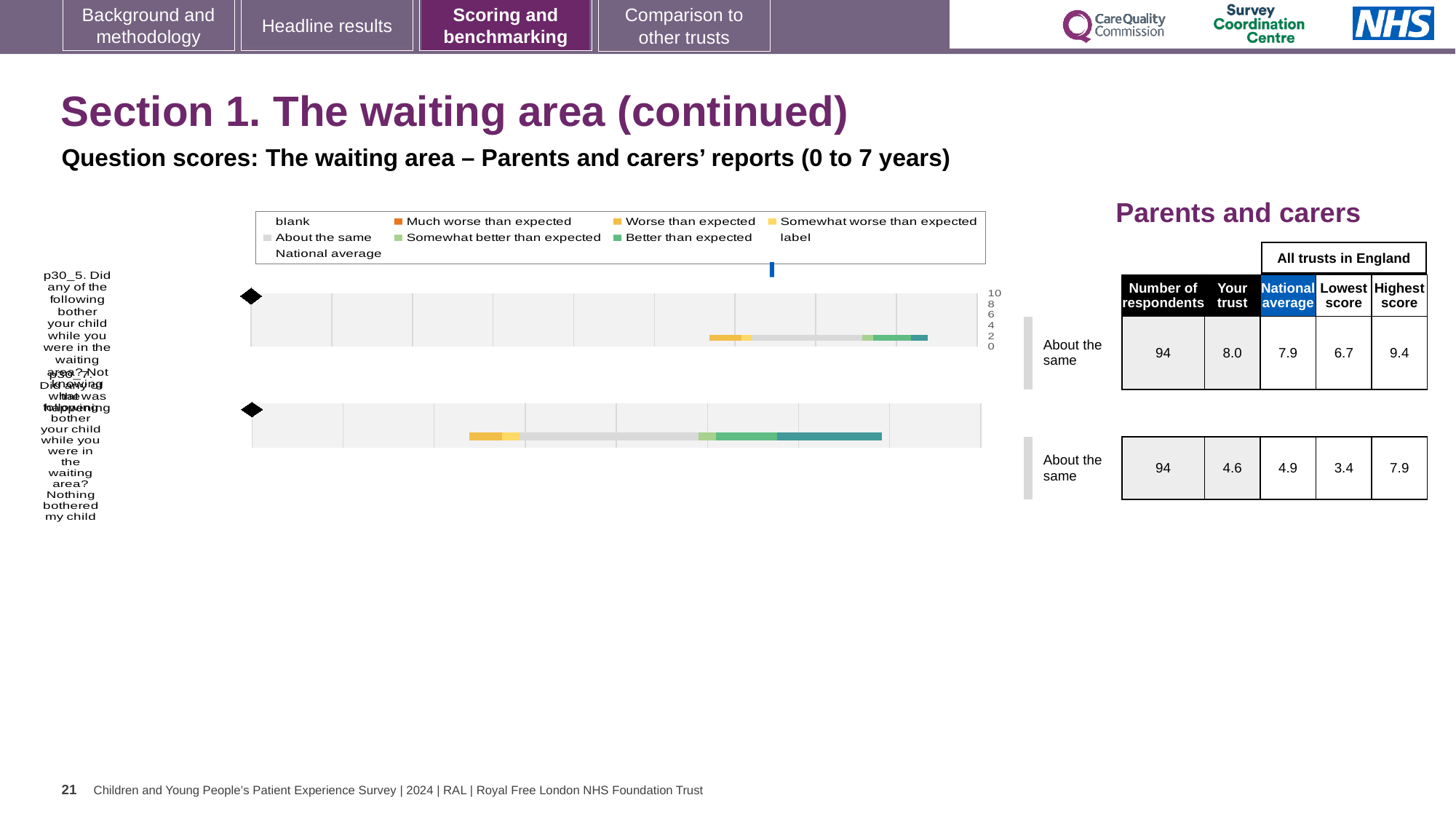
What benchmark category is assigned to both bars in the chart? About the same For the bottom bar (p30_7), which is larger: the 'Your trust' score or the national average? National average What kind of chart is shown on the slide? bar chart What is the 'Your trust' score for the bottom bar (p30_7)? 4.6 What is the difference between the highest and lowest scores for the bottom bar (p30_7)? 4.5 What is the difference between the highest and lowest scores for the top bar (p30_5)? 2.7 How many bars (questions) are plotted in the chart? 2 How many respondents are recorded for the top bar (p30_5)? 94 What is the 'Your trust' score for the top bar (p30_5) in the table beside the chart? 8.0 What is the heading above the table to the right of the chart? Parents and carers What is the highest score among all trusts in England for the bottom bar (p30_7)? 7.9 What is the national average score for the top bar (p30_5)? 7.9